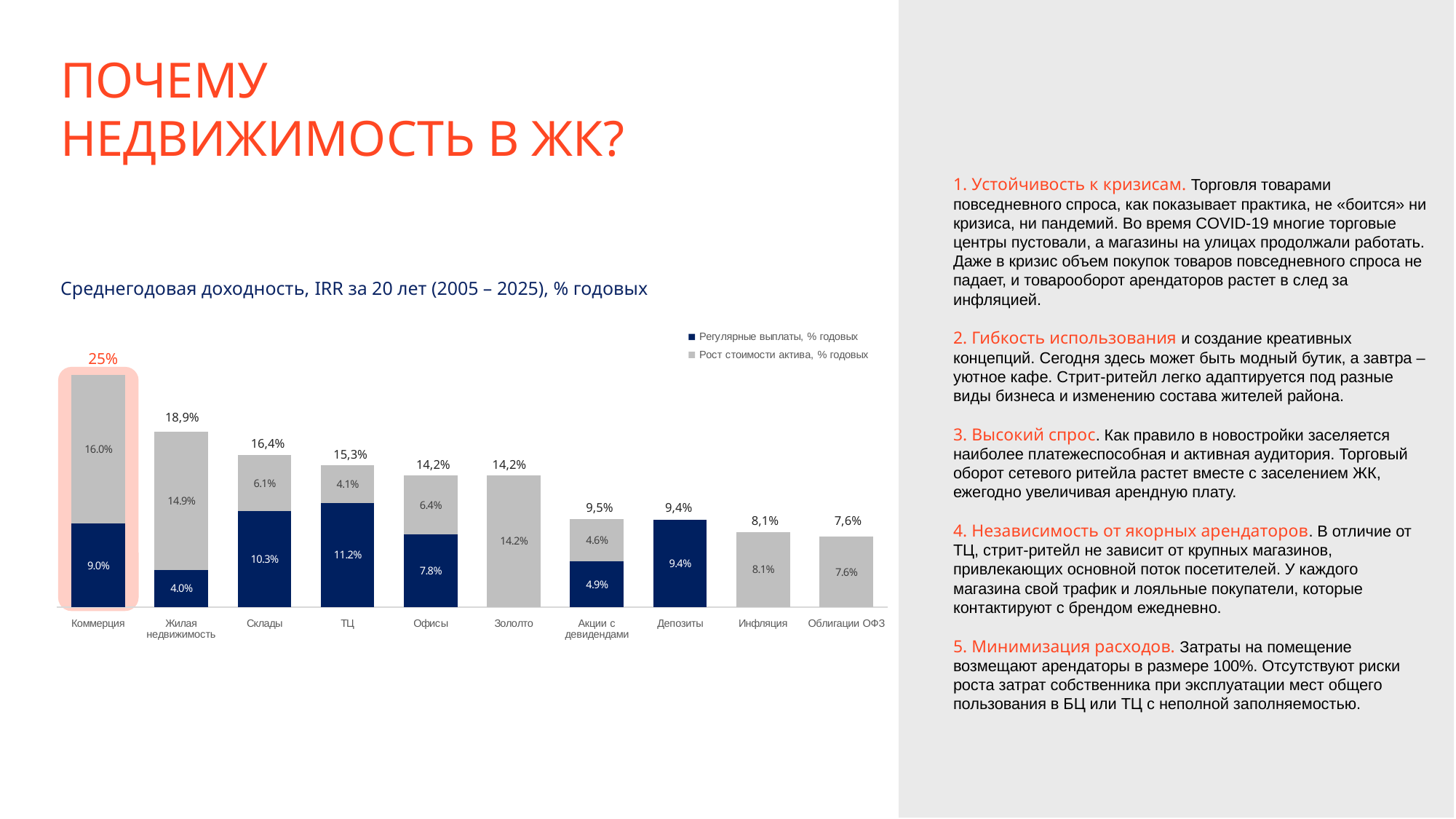
What is the value of 'Рост стоимости актива, % годовых' for Зололто? 14.2% How many categories are shown on the x axis of the chart? 10 What is the total annual return shown above the bar for Склады? 16,4% Which category has the highest total annual return? Коммерция How many series does the chart legend list? 2 What type of chart is shown on the slide? Stacked bar chart Which is larger: the total for Депозиты or the total for Инфляция? Депозиты What is the value of 'Регулярные выплаты, % годовых' for Коммерция? 9.0% What is the title of the chart? Среднегодовая доходность, IRR за 20 лет (2005 – 2025), % годовых What is the difference between the 'Регулярные выплаты' values for ТЦ and Офисы? 3.4% Which category has the lowest total annual return? Облигации ОФЗ What is the value of 'Рост стоимости актива, % годовых' for Жилая недвижимость? 14.9%